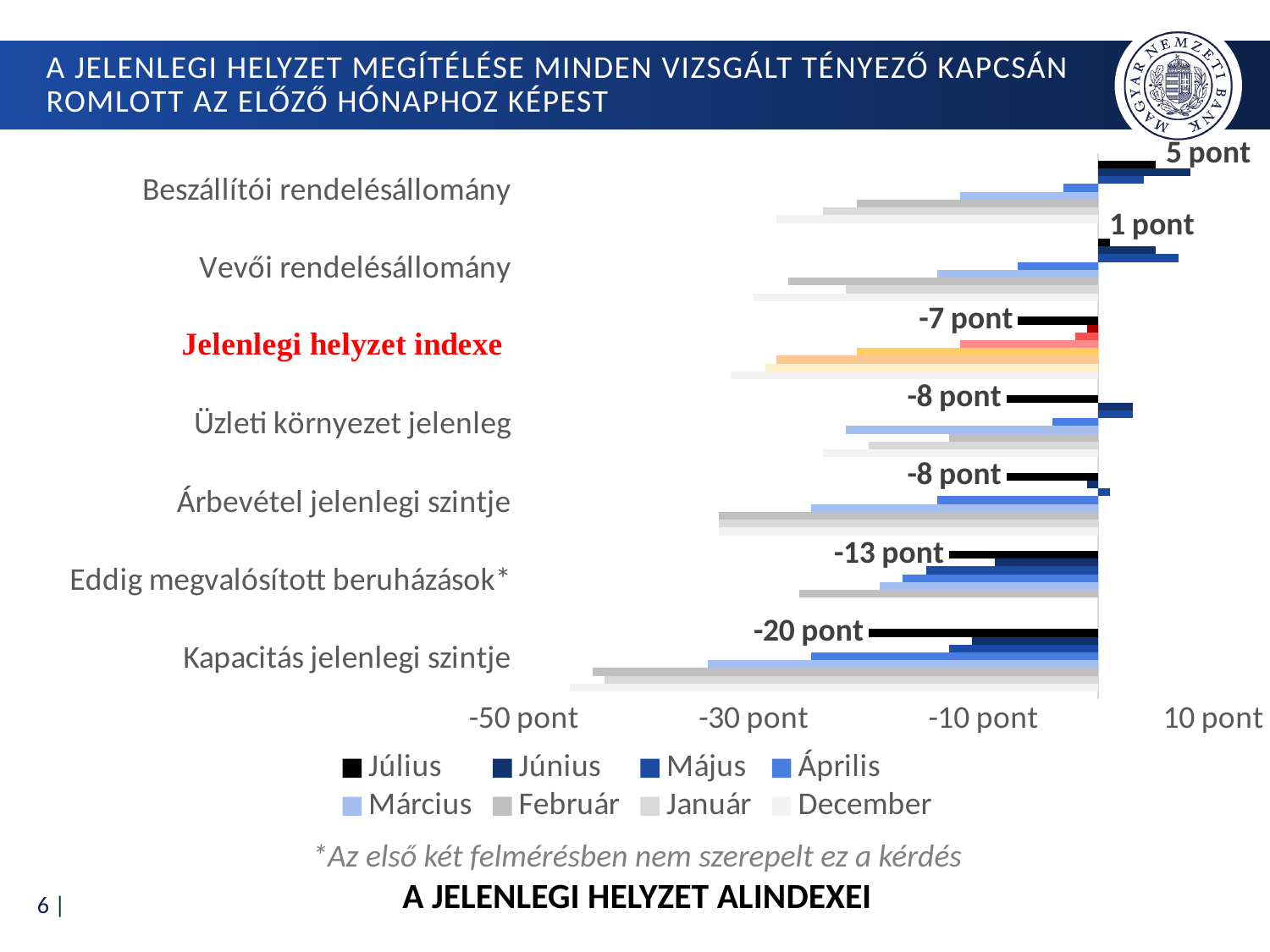
Which has the larger Július value: Jelenlegi helyzet indexe or Eddig megvalósított beruházások*? Jelenlegi helyzet indexe What is the Július value for Kapacitás jelenlegi szintje? -20 pont What is the Július value for Jelenlegi helyzet indexe? -7 pont What is the Július value for Eddig megvalósított beruházások*? -13 pont Is the Július value for Kapacitás jelenlegi szintje greater or less than -10 pont? less How many categories are shown on the chart? 7 How many series does the legend list? 8 What is the difference between the Július values for Beszállítói rendelésállomány and Kapacitás jelenlegi szintje? 25 pont Which category has the highest Július value? Beszállítói rendelésállomány Which category has the lowest Július value? Kapacitás jelenlegi szintje What kind of chart is shown on the slide? bar chart What is the Július value for Beszállítói rendelésállomány? 5 pont